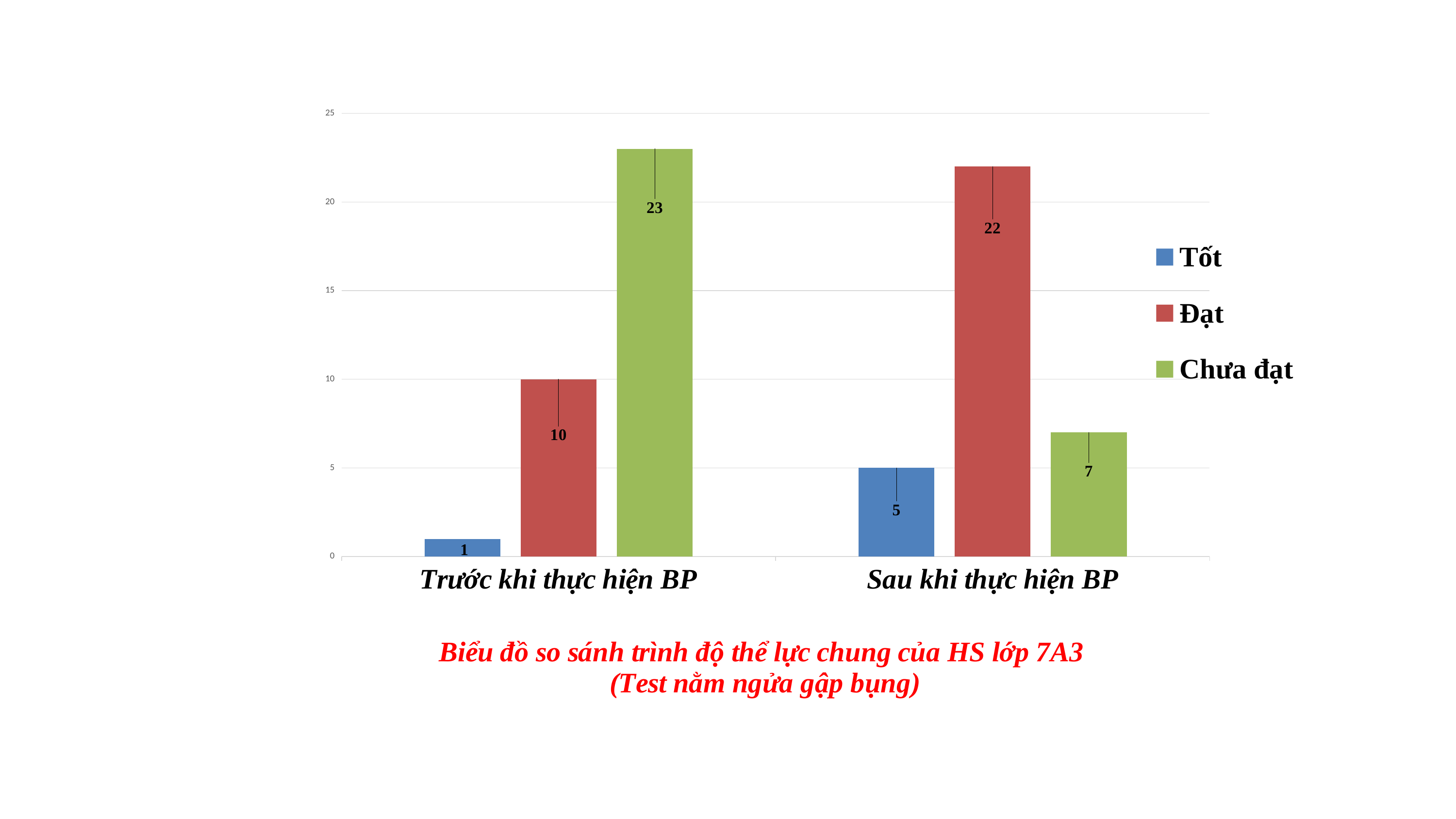
Which colour represents the Đạt series in the legend? red What is the value for Tốt in the Trước khi thực hiện BP category? 1 Which is larger: Đạt in Trước khi thực hiện BP or Đạt in Sau khi thực hiện BP? Đạt in Sau khi thực hiện BP What is the value for Chưa đạt in the Sau khi thực hiện BP category? 7 Which series has the lowest value in the Sau khi thực hiện BP category? Tốt What is the value for Đạt in the Sau khi thực hiện BP category? 22 Which series has the highest value in the Trước khi thực hiện BP category? Chưa đạt How many categories are shown on the x axis? 2 How many series does the legend list? 3 What kind of chart is shown on the slide? bar chart Is the value for Chưa đạt in Trước khi thực hiện BP greater or less than 20? greater What is the difference between the Chưa đạt values for Trước khi thực hiện BP and Sau khi thực hiện BP? 16